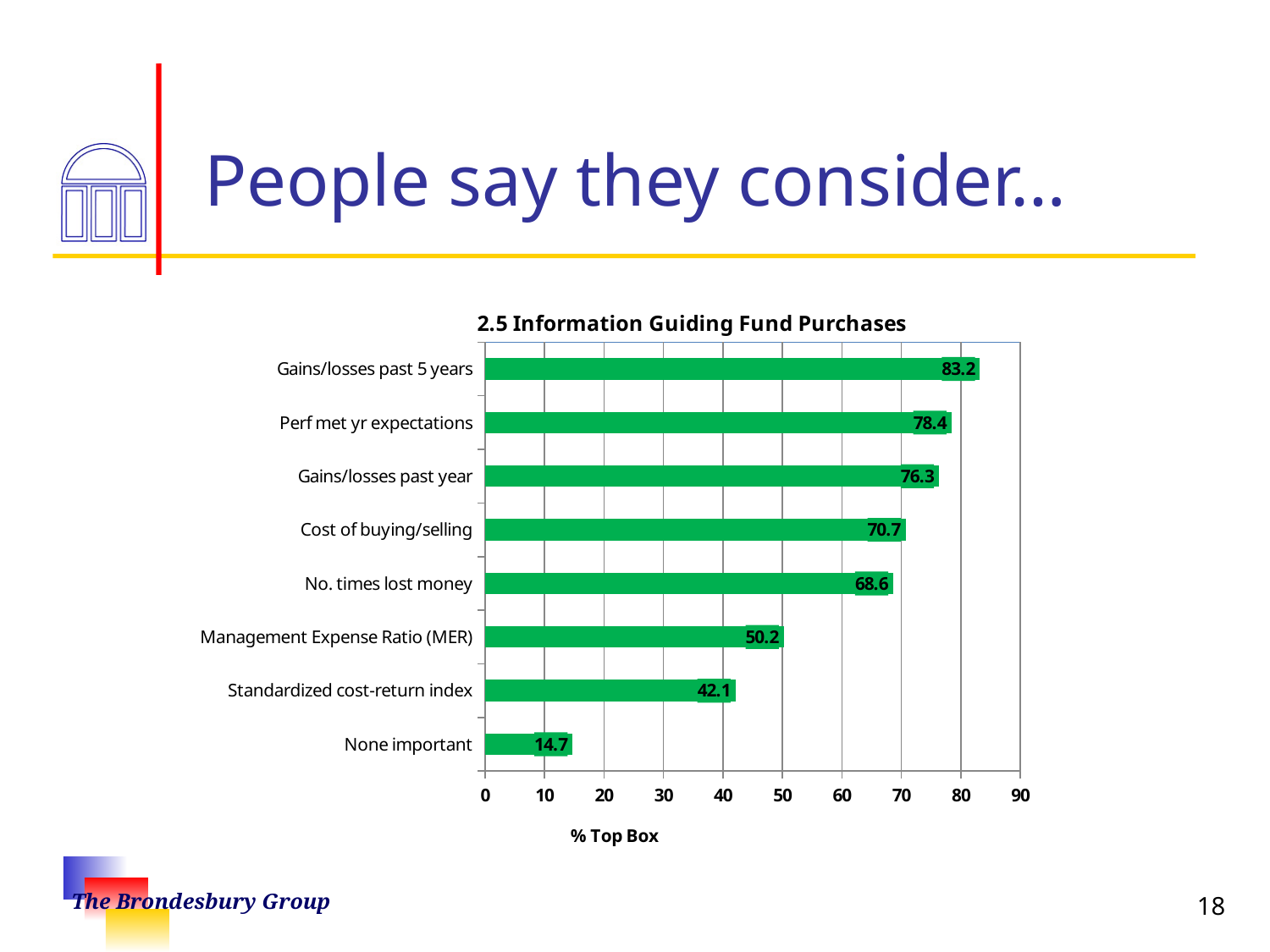
Which category has the lowest value? None important What is the difference between the values for Perf met yr expectations and Gains/losses past year? 2.1 What is the title of the chart? 2.5 Information Guiding Fund Purchases What is the value for Management Expense Ratio (MER)? 50.2 What kind of chart is shown on the slide? bar chart Which is larger, the value for No. times lost money or the value for Management Expense Ratio (MER)? No. times lost money What is the value for None important? 14.7 What is the value for Gains/losses past 5 years? 83.2 Which category has the highest value? Gains/losses past 5 years How many categories are shown in the chart? 8 Is the value for Standardized cost-return index greater or less than 50? less What is the difference between the values for Cost of buying/selling and Standardized cost-return index? 28.6